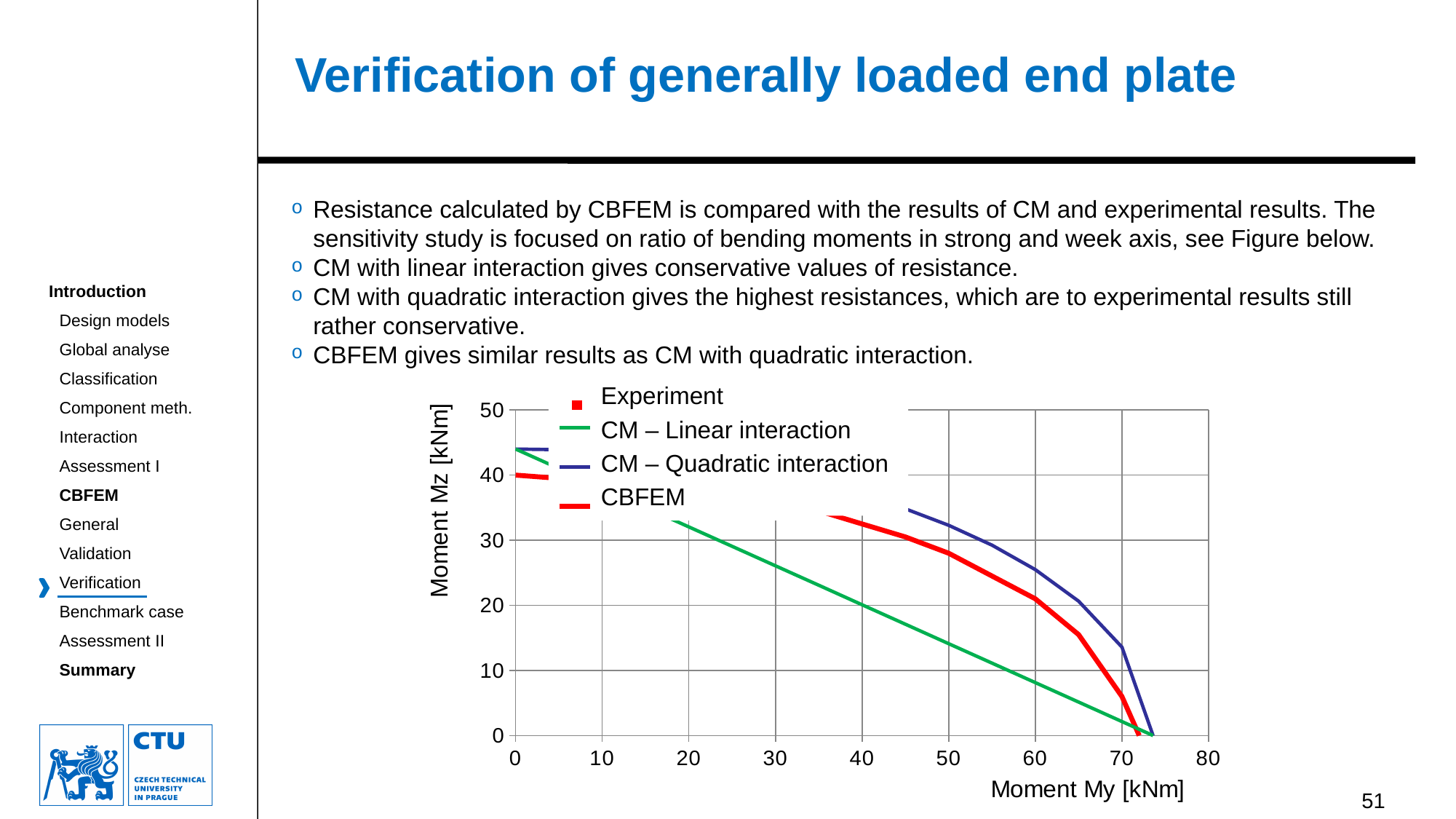
At Moment My = 60 kNm, which series has the larger Moment Mz value: CM – Quadratic interaction or CM – Linear interaction? CM – Quadratic interaction Is the Moment Mz value of the CM – Linear interaction series at Moment My = 20 greater or less than 30? greater What is the title of the horizontal axis of the chart? Moment My [kNm] Do the values of the CBFEM series rise or fall as Moment My increases? fall Do the values of the CM – Linear interaction series rise or fall as Moment My increases? fall Is the Moment Mz value of the CM – Quadratic interaction series at Moment My = 50 greater or less than 30? greater What kind of chart is shown on the slide? line chart At Moment My = 60 kNm, which series has the larger Moment Mz value: CBFEM or CM – Linear interaction? CBFEM How many series does the chart legend list? 4 Is the Moment Mz value of the CBFEM series at Moment My = 70 greater or less than 10? less What is the title of the vertical axis of the chart? Moment Mz [kNm]